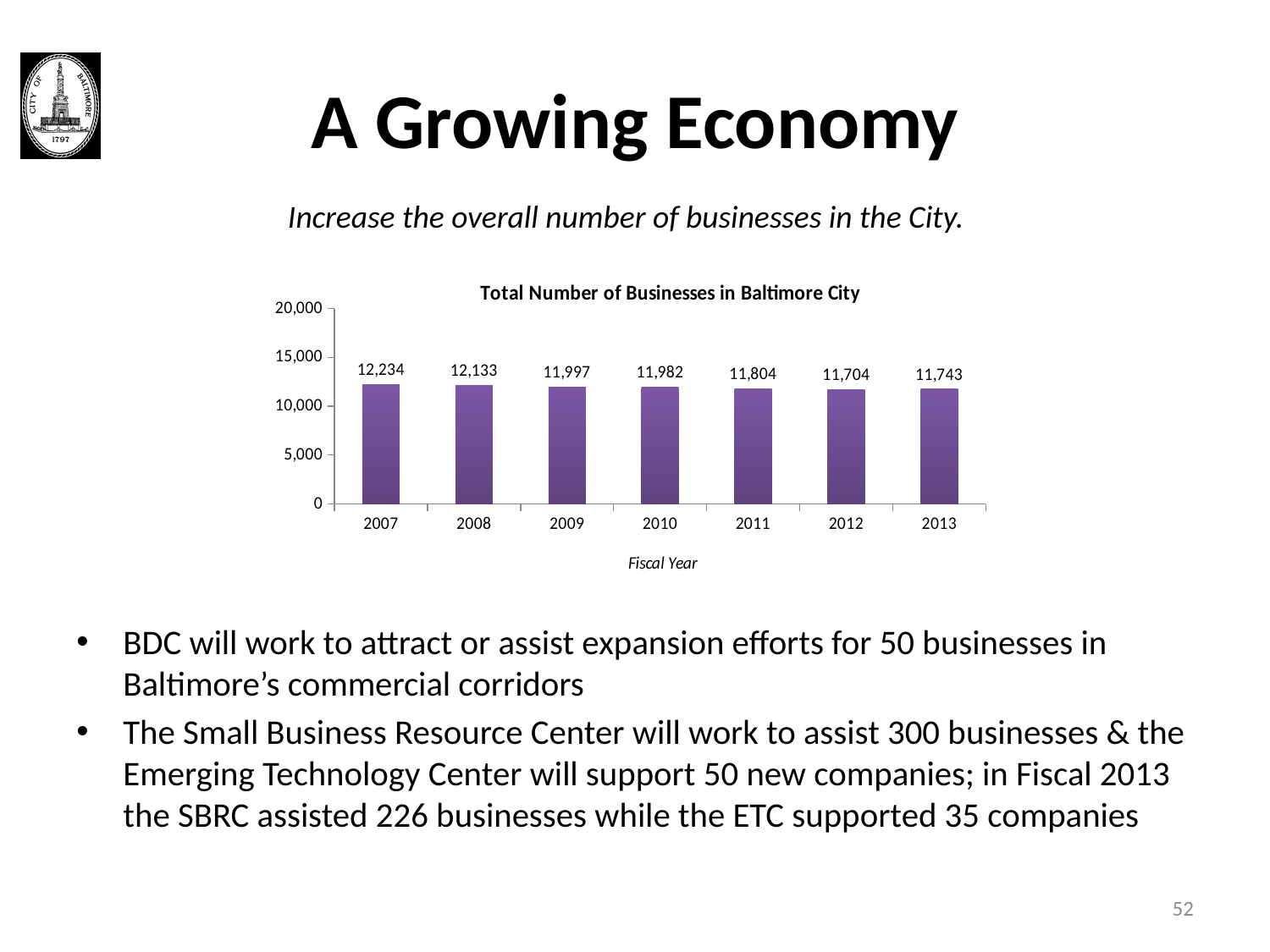
What is the total number of businesses in Baltimore City in 2013? 11,743 Which fiscal year has the highest number of businesses? 2007 Is the value for 2008 greater or less than 15,000? less Which fiscal year has the lowest number of businesses? 2012 What is the title of the chart? Total Number of Businesses in Baltimore City What is the difference between the values for 2011 and 2012? 100 How many fiscal years are shown on the chart? 7 What is the value shown for fiscal year 2010? 11,982 What is the difference between the number of businesses in 2007 and 2013? 491 What is the total number of businesses in Baltimore City in 2007? 12,234 Which year has more businesses, 2009 or 2011? 2009 What kind of chart is used to show the total number of businesses? bar chart